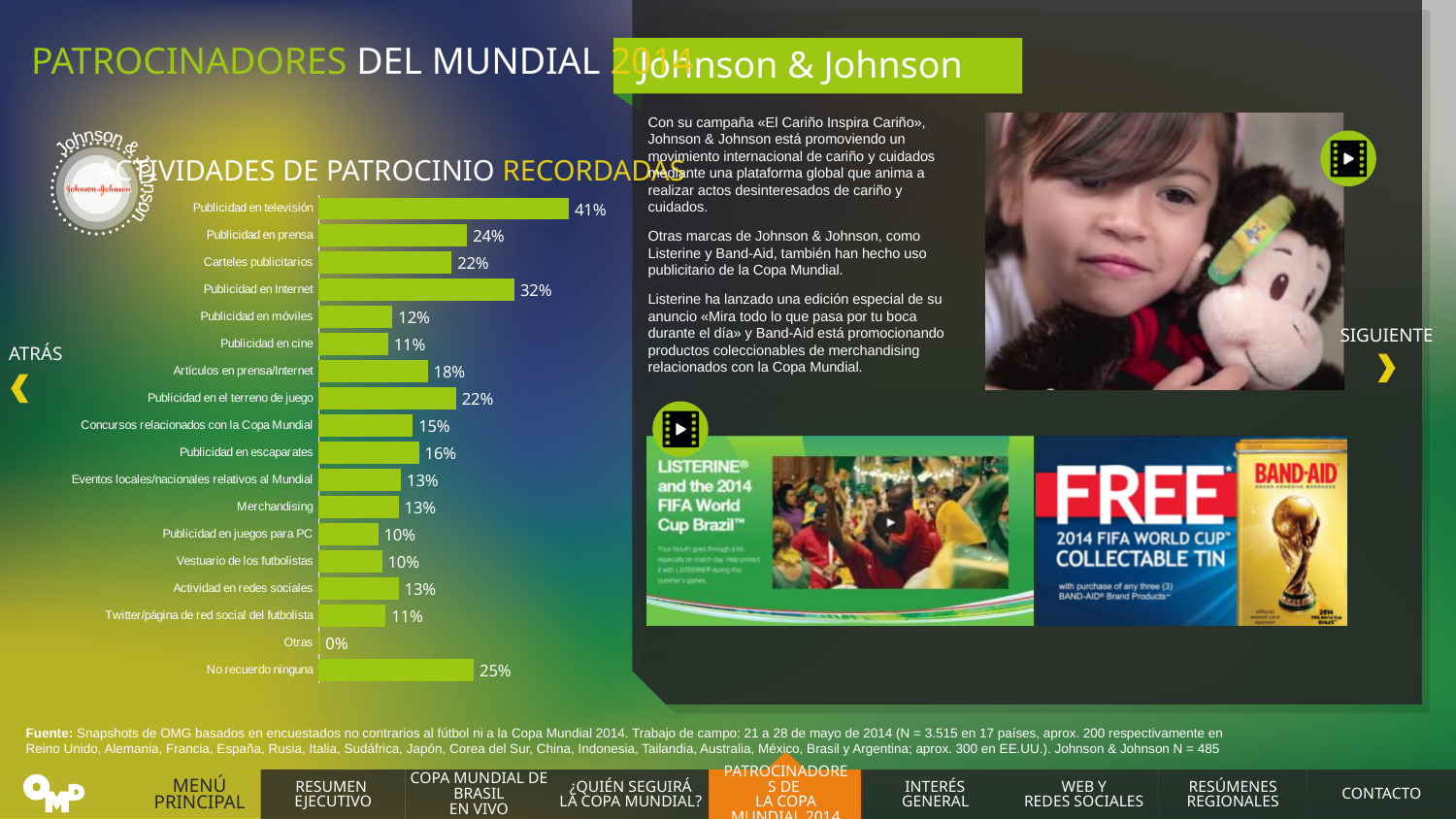
What kind of chart is shown on the slide? Bar chart What is the title of the chart? ACTIVIDADES DE PATROCINIO RECORDADAS Which category has the highest value in the chart? Publicidad en televisión What is the difference between the values for No recuerdo ninguna and Publicidad en prensa? 1% What value is shown for Publicidad en Internet? 32% How many categories are shown in the chart? 18 Which category has the lowest value in the chart? Otras What value is shown for Publicidad en televisión? 41% What value is shown for No recuerdo ninguna? 25% What value is shown for Merchandising? 13% Which is larger, the value for Publicidad en prensa or the value for Artículos en prensa/Internet? Publicidad en prensa What is the difference between the values for Publicidad en televisión and Publicidad en Internet? 9%